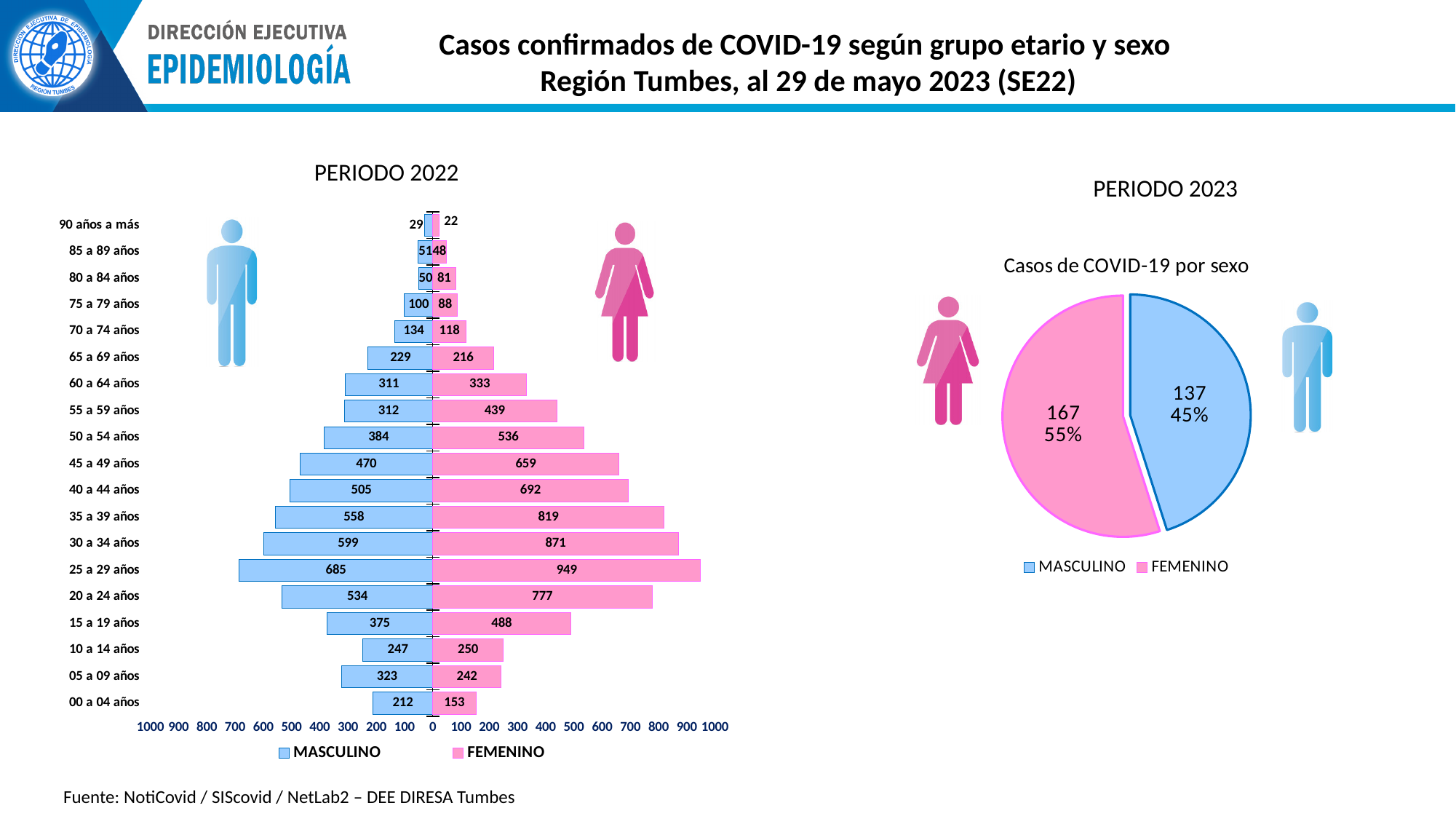
In the PERIODO 2022 chart, what is the MASCULINO value for the 25 a 29 años group? 685 In the PERIODO 2022 chart, what is the FEMENINO value for the 35 a 39 años group? 819 In the PERIODO 2022 chart, what is the difference between the FEMENINO and MASCULINO values for the 30 a 34 años group? 272 In the PERIODO 2022 chart, which age group has the highest FEMENINO value? 25 a 29 años What kind of chart is the PERIODO 2022 chart? Bar chart In the PERIODO 2022 chart, which age group has the lowest MASCULINO value? 90 años a más In the PERIODO 2023 pie chart, what is the value for FEMENINO? 167 In the PERIODO 2022 chart, which is larger for the 05 a 09 años group, MASCULINO or FEMENINO? MASCULINO In the PERIODO 2023 pie chart, what share of cases is MASCULINO? 45% What is the title of the pie chart on the right of the slide? Casos de COVID-19 por sexo How many age groups are shown in the PERIODO 2022 chart? 19 How many series does the legend of the PERIODO 2022 chart list? 2